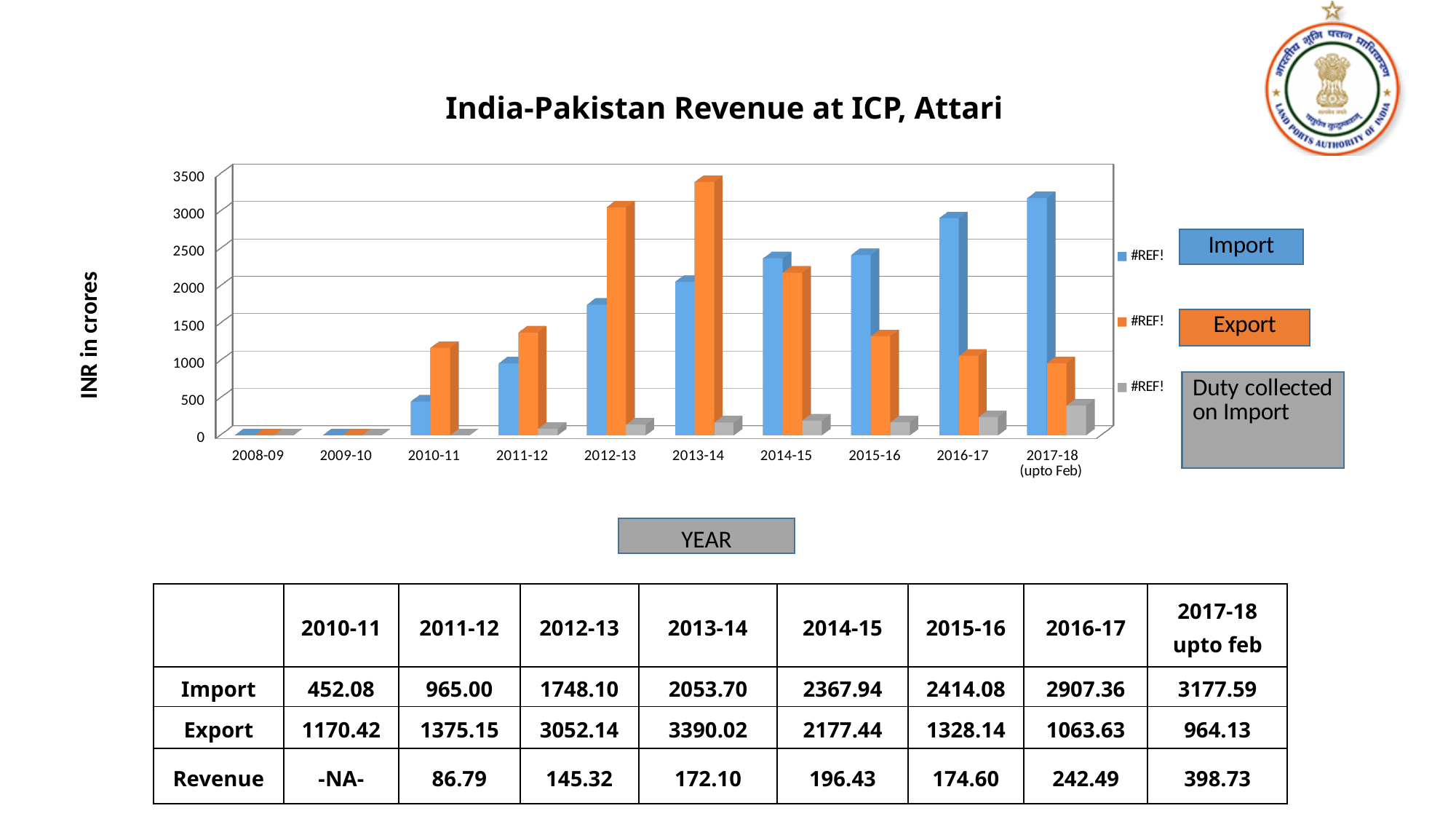
By how much does Export exceed Import in 2013-14? 1336.32 What is the title of the chart? India-Pakistan Revenue at ICP, Attari What is the label on the vertical axis of the chart? INR in crores How many data series does the chart plot? 3 What is the Import value for 2013-14? 2053.70 How many years are shown along the x axis of the chart? 10 What is the Export value for 2012-13? 3052.14 In which year is the Export bar highest? 2013-14 In 2015-16, which is larger, Import or Export? Import Is the Export value for 2016-17 greater or less than 1500? less In which year is the Import bar highest? 2017-18 (upto Feb) What kind of chart is shown on the slide? bar chart